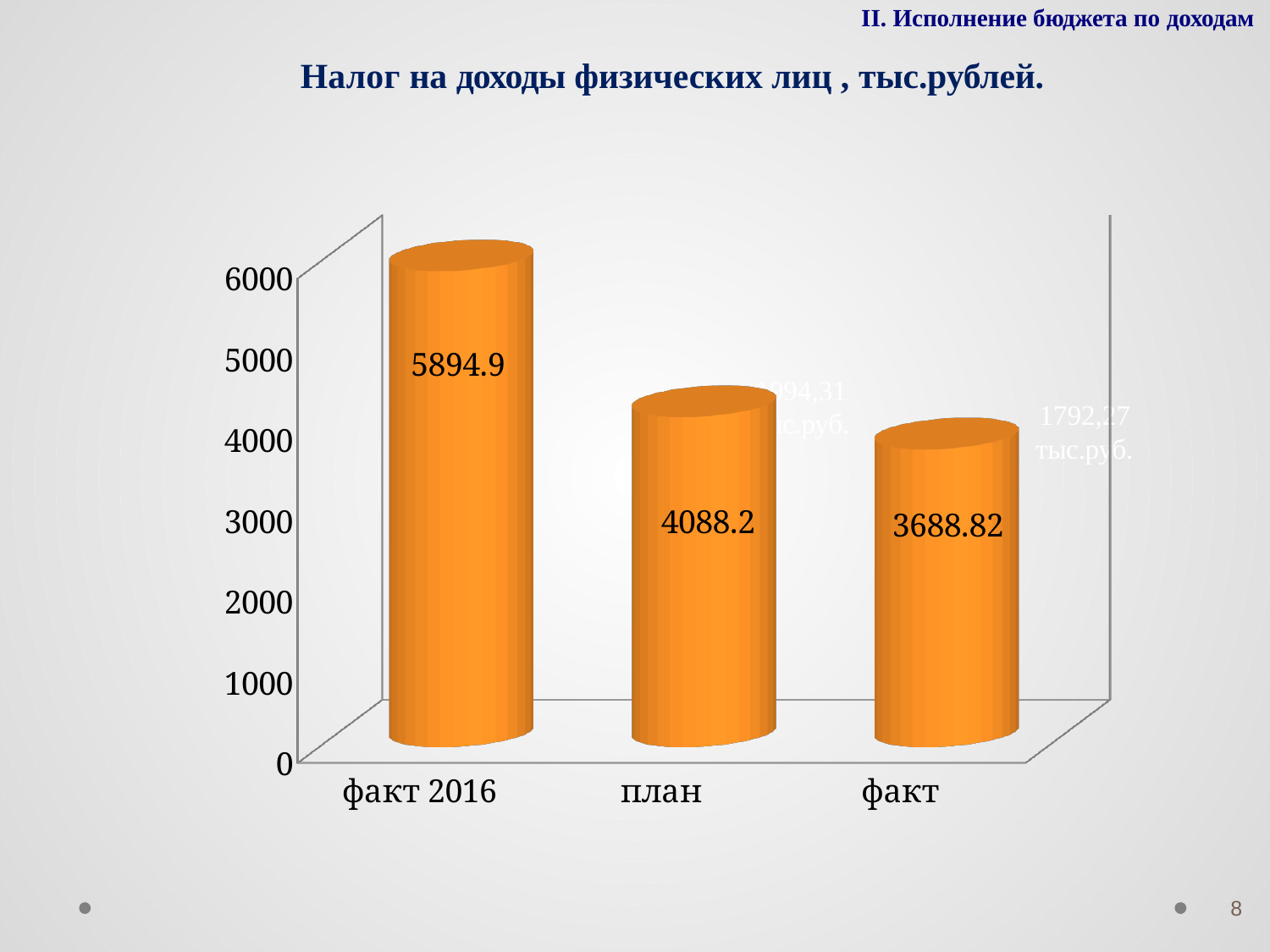
Which category has the highest value? факт 2016 Which is larger, the value for план or the value for факт? план Which category has the lowest value? факт What is the difference between the values for план and факт? 399.38 How many categories are shown on the x axis? 3 What is the title of the chart? Налог на доходы физических лиц , тыс.рублей. What is the difference between the values for факт 2016 and план? 1806.7 What is the value for факт 2016? 5894.9 What is the value for факт? 3688.82 What is the value for план? 4088.2 What kind of chart is shown on the slide? bar chart Is the value for факт 2016 greater or less than 5000? greater